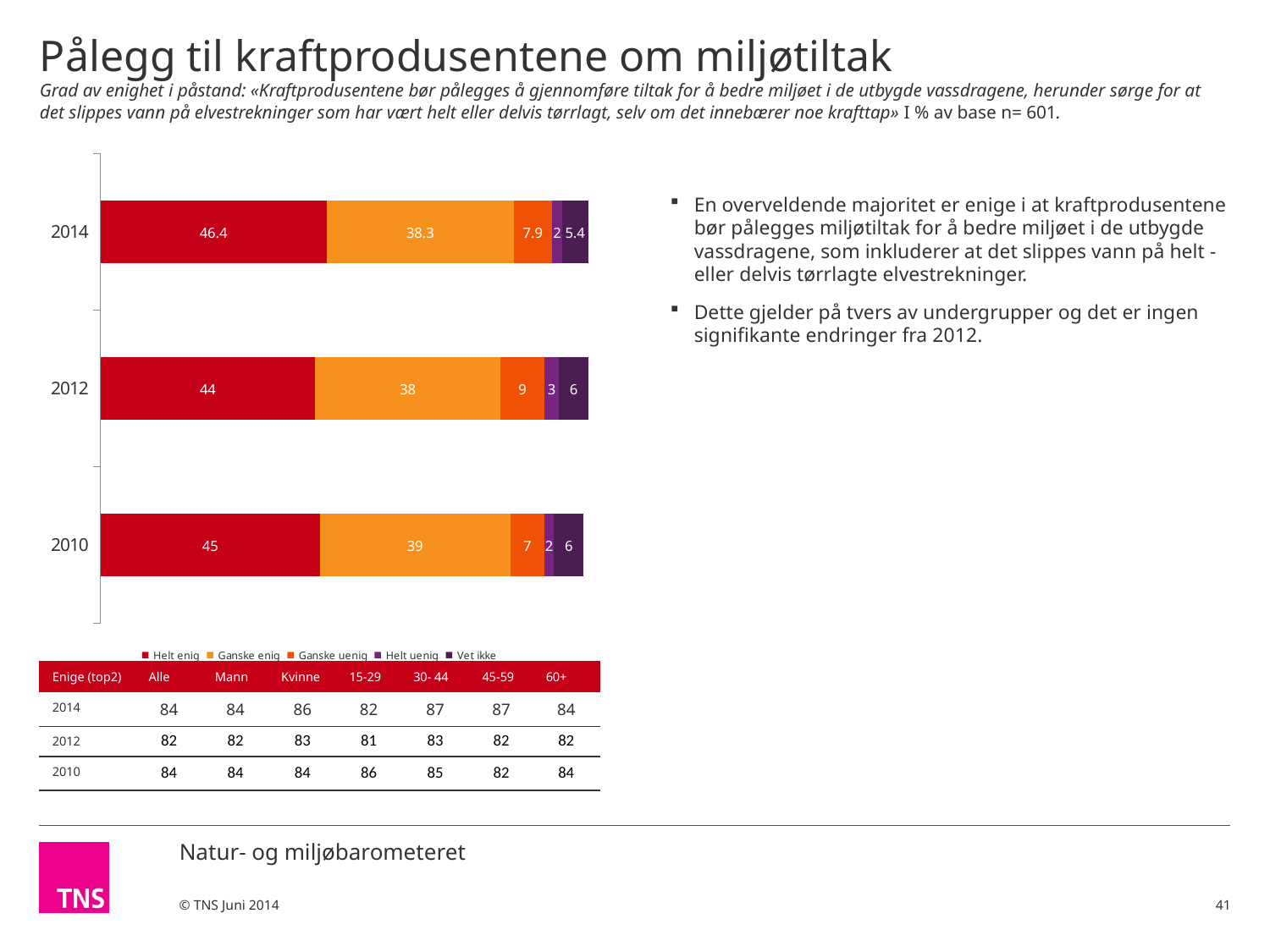
How many years (categories) are shown in the bar chart? 3 Which year has the lowest value for "Ganske uenig"? 2010 What kind of chart is shown on the slide? Stacked bar chart Which is larger: "Ganske uenig" in 2012 or "Ganske uenig" in 2014? 2012 What is the value for "Ganske uenig" in 2010? 7 What is the value for "Ganske enig" in 2012? 38 What is the difference between the "Helt enig" values for 2014 and 2012? 2.4 What is the value for "Vet ikke" in 2014? 5.4 Which year has the highest value for "Helt enig"? 2014 What is the value for "Helt enig" in 2014? 46.4 What is the total of the stacked bar for 2010? 99 How many series does the legend list? 5